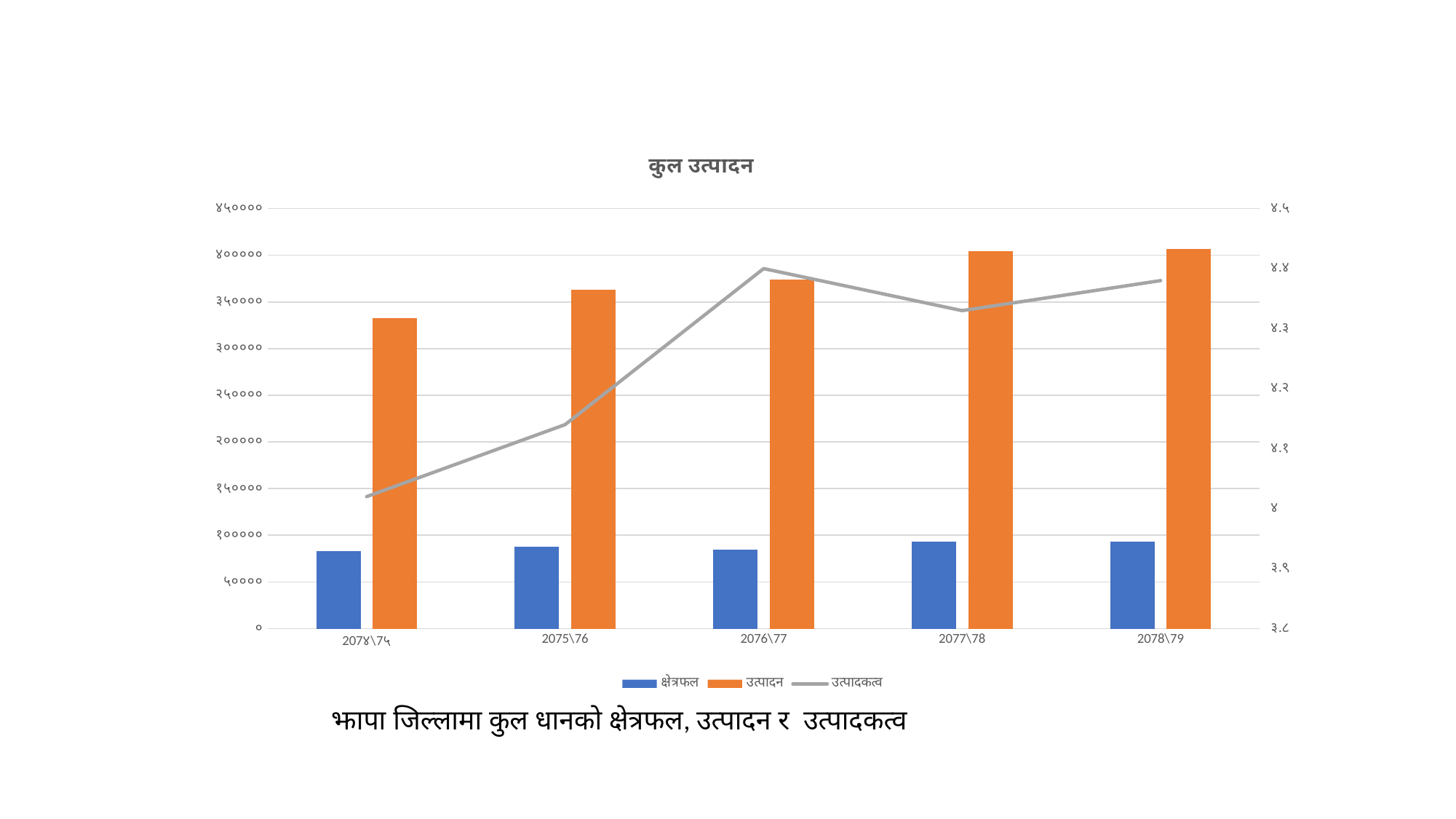
How many series does the legend list? 3 In which year is the उत्पादकत्व line at its lowest point? 2074\75 Do the उत्पादन bars generally rise or fall from 2074\75 to 2078\79? rise Which series is drawn as a line rather than bars? उत्पादकत्व What is the title of the chart? कुल उत्पादन What kind of chart is shown on the slide? Combination bar and line chart In which year does the उत्पादकत्व line reach its highest point? 2076\77 In which year is the उत्पादन bar the lowest? 2074\75 How many categories are shown on the x axis? 5 Is the उत्पादन value for 2074\75 greater or less than ३००००० (300000)? greater Is the उत्पादकत्व value for 2075\76 greater or less than ४.२ (4.2)? less Is the क्षेत्रफल value for 2074\75 greater or less than १००००० (100000)? less